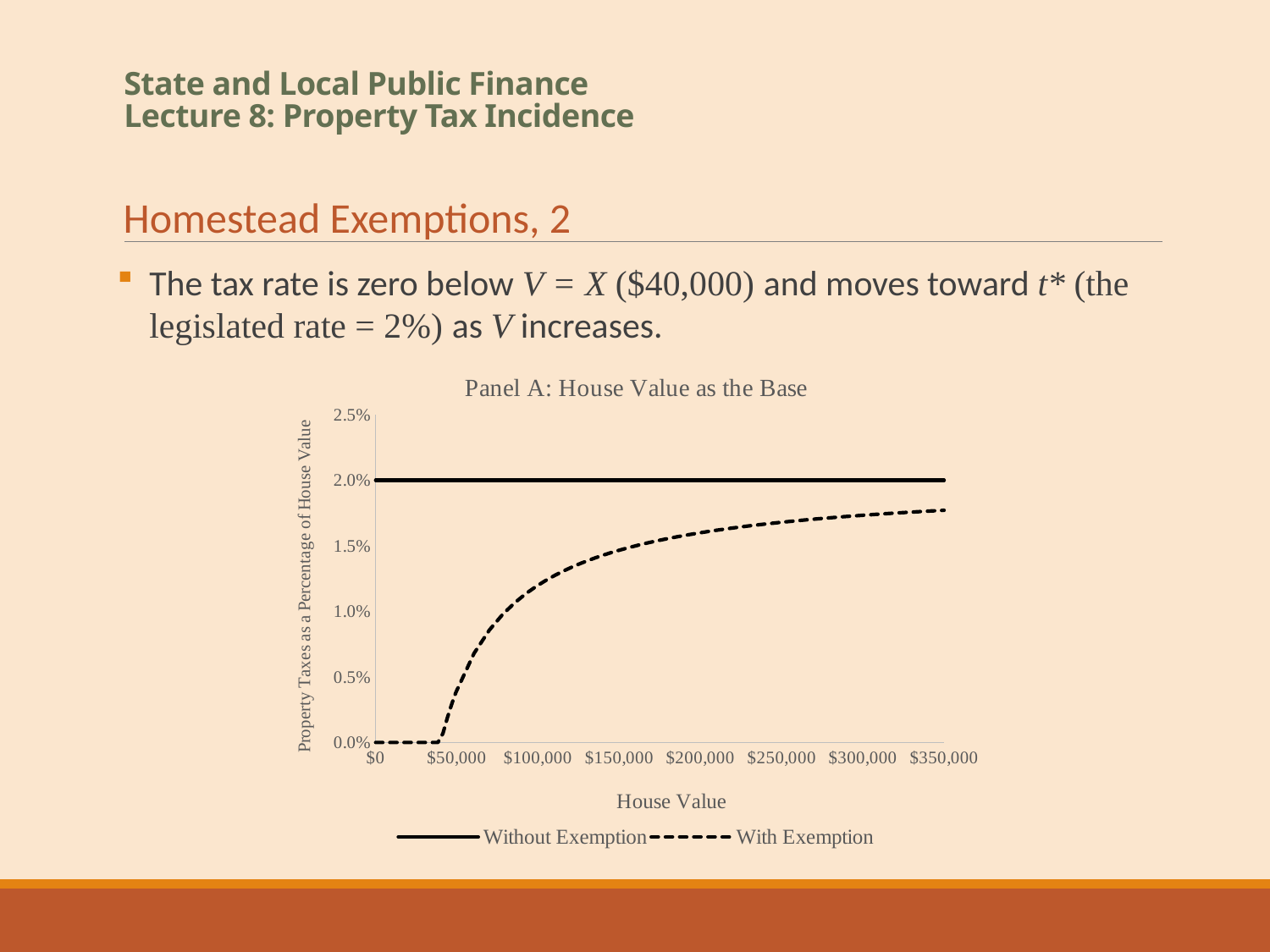
How many series does the chart's legend list? 2 What is the title of the chart? Panel A: House Value as the Base Does the With Exemption series rise or fall as house value increases beyond $50,000? rise Is the value of the With Exemption series at $50,000 greater or less than 1.0%? less Is the value of the With Exemption series at $100,000 greater or less than 1.5%? less Which series is drawn with a dashed line? With Exemption What is the value of the With Exemption series at a house value of $0? 0.0% What value does the Without Exemption line stay at across all house values? 2.0% Is the Without Exemption line greater or less than 2.5%? less At a house value of $200,000, which series has the higher value, Without Exemption or With Exemption? Without Exemption What kind of chart is shown on the slide? line chart